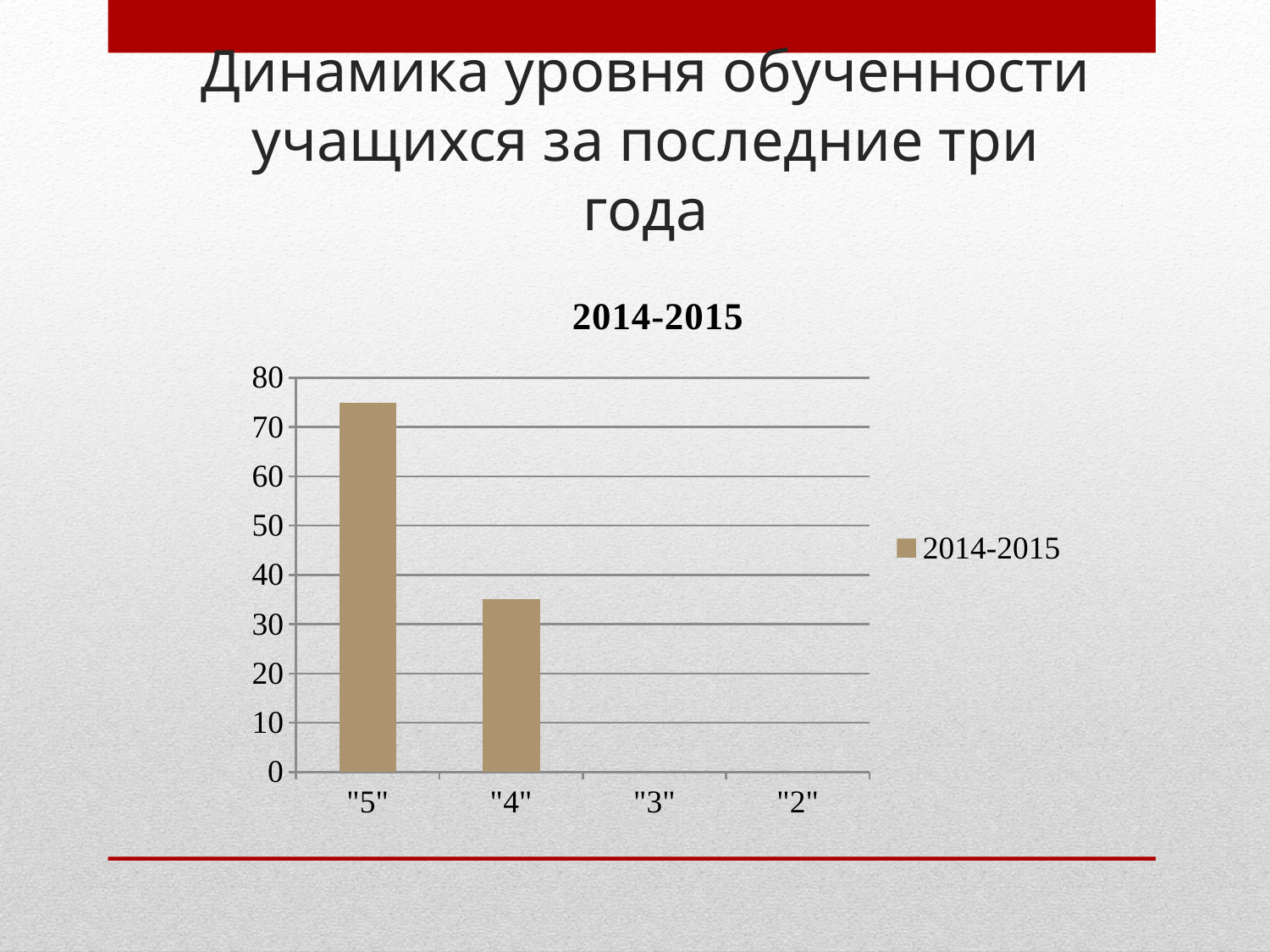
Do the values rise or fall moving along the x axis from "5" to "2"? fall Is the value for "4" greater or less than 30? greater How many categories are shown on the x axis? 4 Is the value for "4" greater or less than 40? less What is the legend entry for the series? 2014-2015 Which category has the highest value? "5" What is the title of the chart? 2014-2015 Is the value for "5" greater or less than 70? greater What kind of chart is shown on the slide? bar chart How many series does the legend list? 1 Which is larger, the value for "5" or the value for "4"? "5"